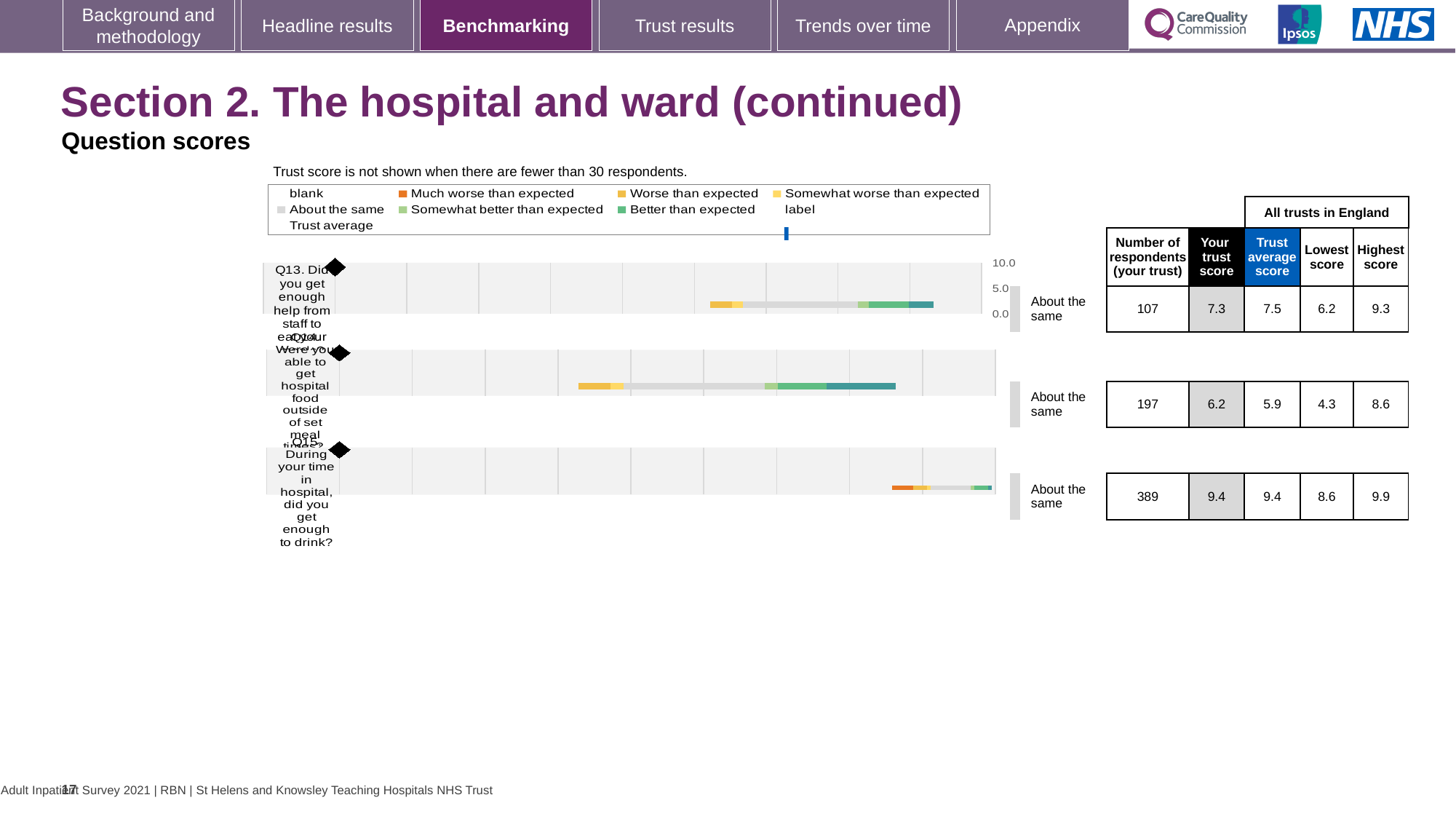
Which question has the lowest trust score for this trust? Q14 What is the maximum value shown on the score axis of the charts? 10.0 What is the trust score for Q13 (Did you get enough help from staff to eat your meals?) shown in the table? 7.3 What is the trust average score for Q14 (Were you able to get hospital food outside of set meal times?)? 5.9 For Q13, is the trust score or the trust average score larger? Trust average score What is the highest score across all trusts in England for Q15? 9.9 How many respondents answered Q15 (did you get enough to drink?) for this trust? 389 How many questions (Q13, Q14, Q15) are plotted on the slide? 3 Which question has the largest number of respondents? Q15 What is the difference between the highest score and the lowest score for Q14? 4.3 What benchmark category is shown next to each of the three questions? About the same What kind of chart is used to show the question scores on this slide? bar chart